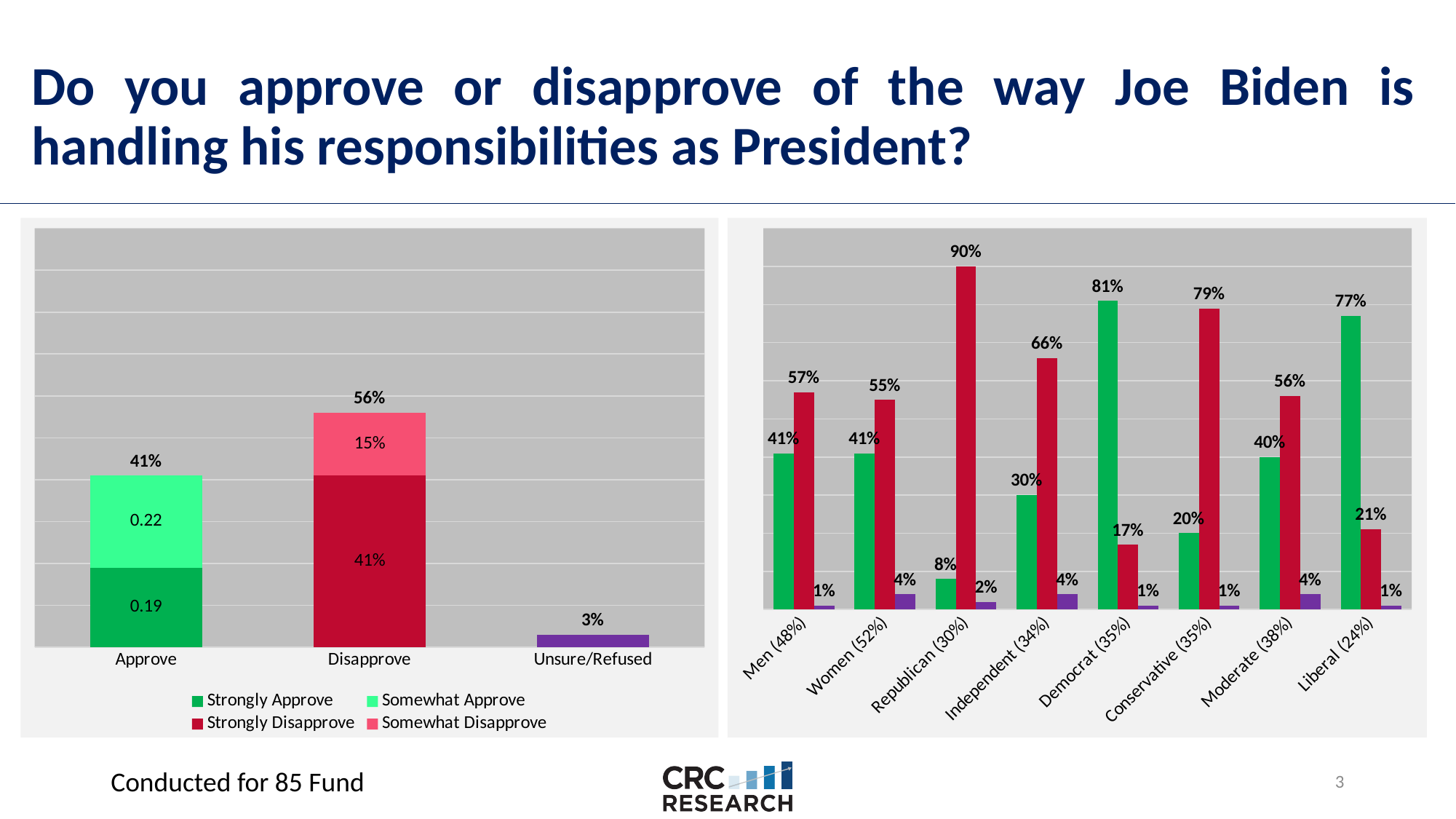
On the left chart, what is the Strongly Disapprove value within the Disapprove bar? 41% On the right chart, which category has the lowest green bar? Republican (30%) On the left chart, what is the difference between the Disapprove total and the Approve total? 15% On the right chart, is the red bar for Independent (34%) larger or smaller than the red bar for Moderate (38%)? Larger On the left chart, what is the total value shown above the Disapprove bar? 56% On the left chart, what kind of chart is shown? Stacked bar chart On the right chart, which category has the highest green bar? Democrat (35%) On the right chart, what is the value of the red bar for Republican (30%)? 90% On the left chart, how many series does the legend list? 4 On the right chart, what is the value of the green bar for Democrat (35%)? 81% On the right chart, how many categories are shown on the x axis? 8 On the left chart, what is the value for Unsure/Refused? 3%